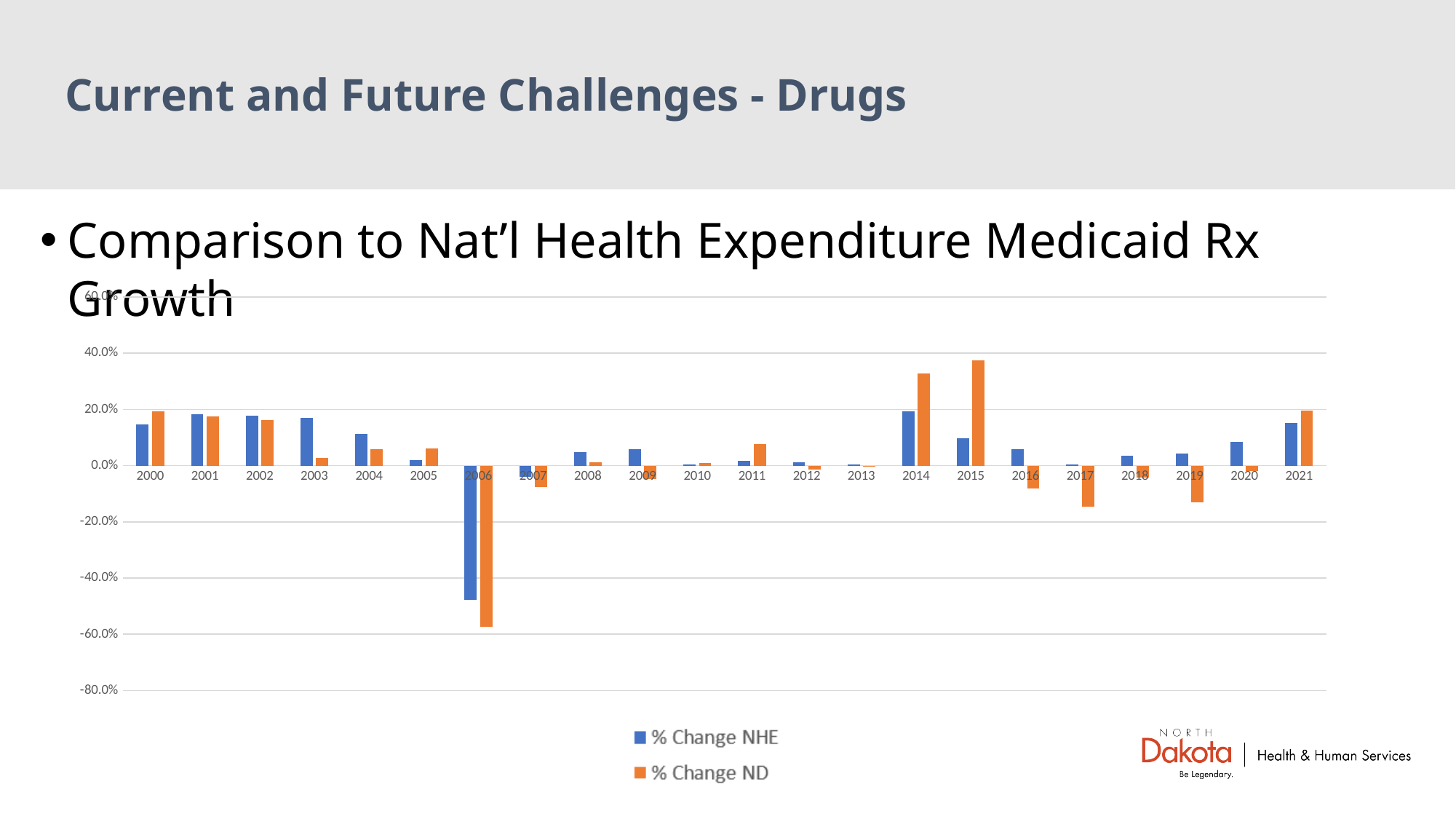
Is the % Change ND value for 2015 greater or less than 20.0%? greater Is the % Change NHE value for 2006 greater or less than -40.0%? less What kind of chart is shown on the slide? Bar chart In which year is the % Change NHE value the lowest? 2006 How many series does the chart legend list? 2 How many years are shown along the x axis of the chart? 22 In 2003, which series has the larger value, % Change NHE or % Change ND? % Change NHE In which year is the % Change ND value the lowest? 2006 Is the % Change ND value for 2017 greater or less than 0.0%? less In 2015, which series has the larger value, % Change NHE or % Change ND? % Change ND Which colour represents the % Change ND series in the chart? Orange In which year is the % Change ND value the highest? 2015